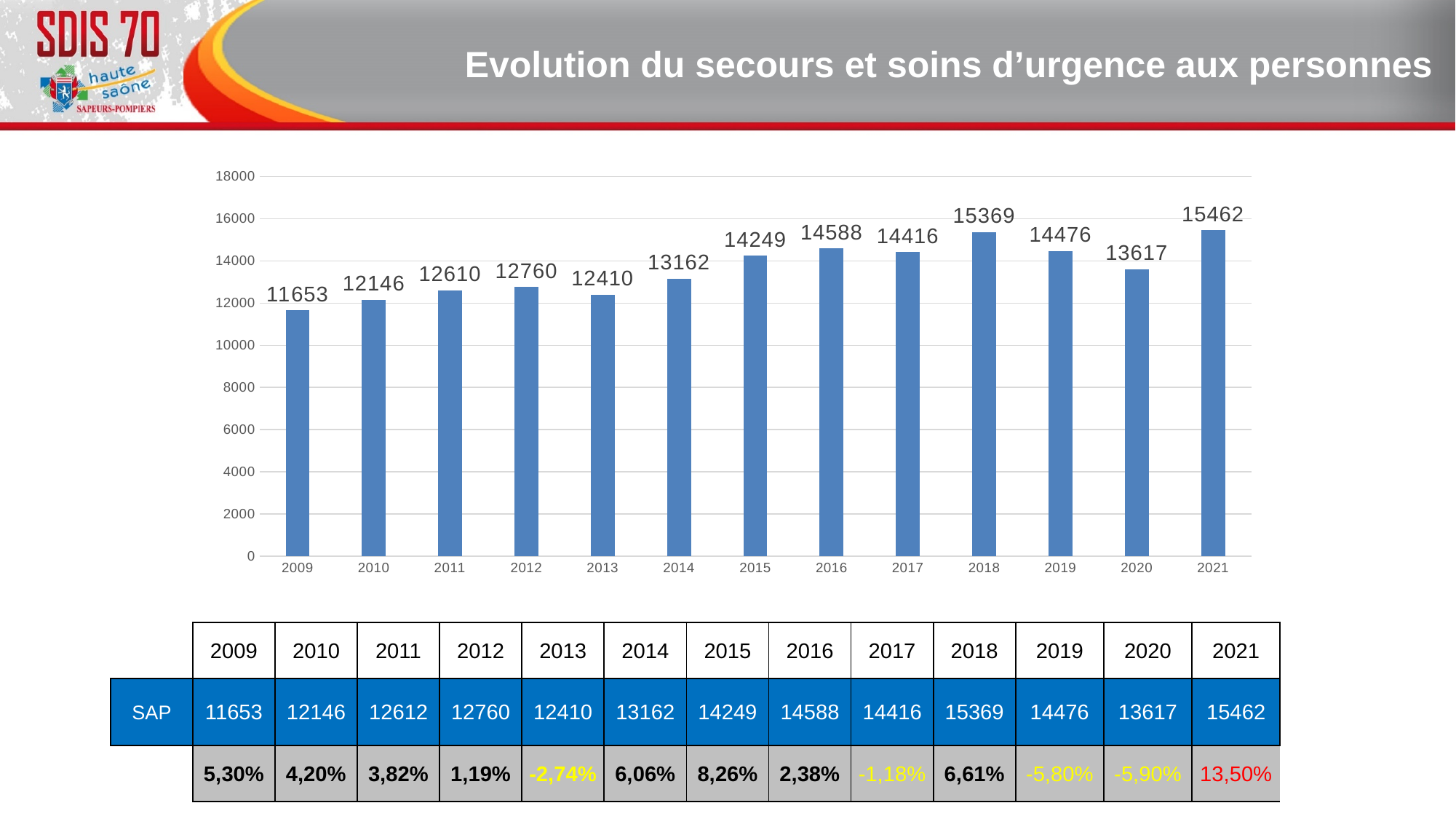
Which year has the lowest value? 2009 What is the value for 2016? 14588 What is the value for 2021? 15462 What kind of chart is shown on the slide? bar chart What is the difference between the values for 2021 and 2020? 1845 How many years are shown on the x axis of the chart? 13 Is the value for 2020 greater or less than 14000? less What is the difference between the values for 2018 and 2017? 953 What is the title of the slide? Evolution du secours et soins d’urgence aux personnes What is the value for 2009? 11653 Which year has the highest value? 2021 Which is larger, the value for 2014 or the value for 2013? 2014